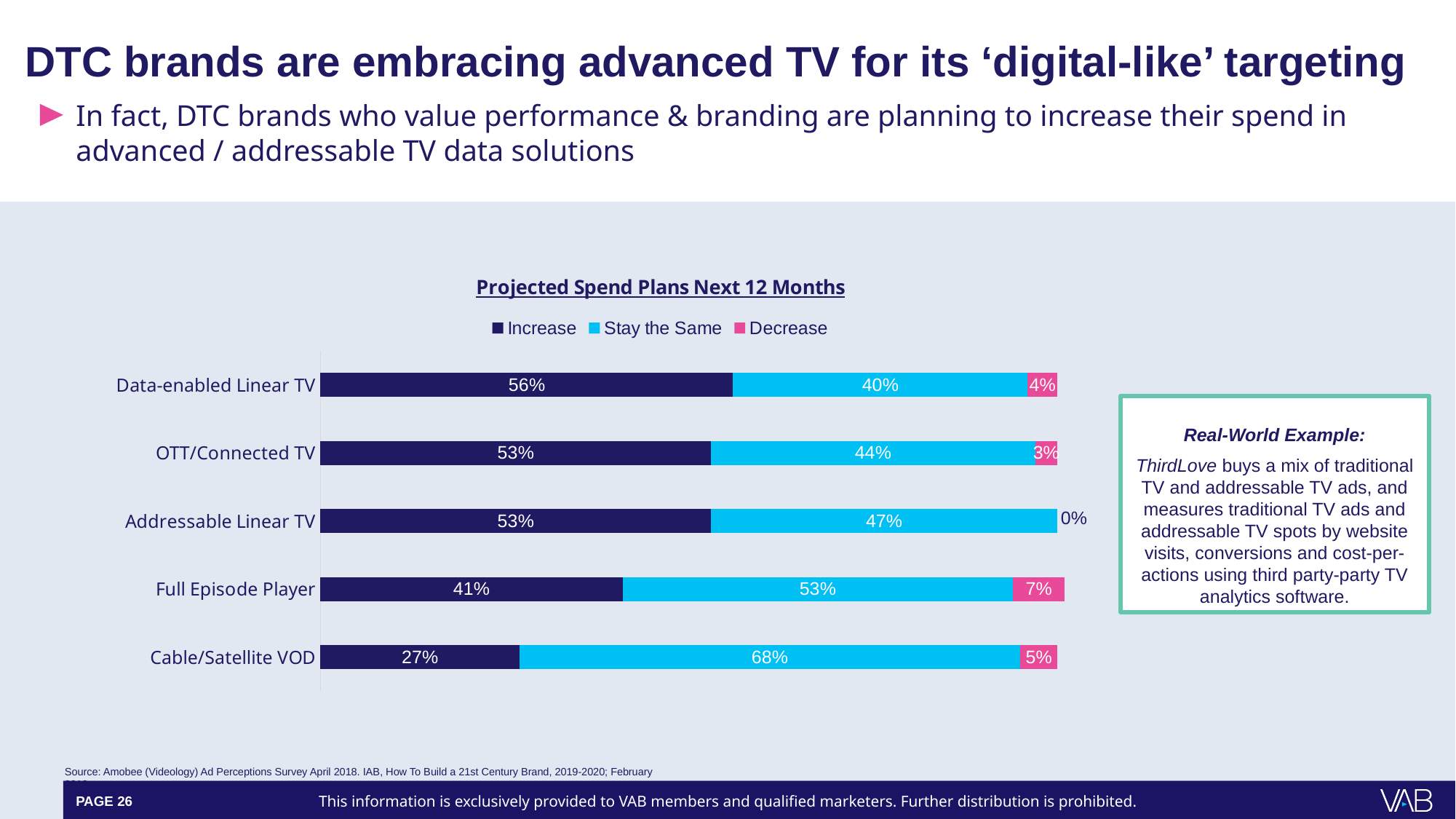
What is the Increase value for Data-enabled Linear TV? 56% What is the Decrease value for Addressable Linear TV? 0% Which category has the highest Increase value? Data-enabled Linear TV What is the Decrease value for Full Episode Player? 7% What is the difference between the Increase values for Data-enabled Linear TV and Cable/Satellite VOD? 29% What is the title of the chart? Projected Spend Plans Next 12 Months Which category has the lowest Increase value? Cable/Satellite VOD How many series does the legend list? 3 What kind of chart is shown on the slide? Stacked bar chart How many categories are shown in the chart? 5 Which is larger: the Stay the Same value for OTT/Connected TV or for Addressable Linear TV? Addressable Linear TV What is the Stay the Same value for Cable/Satellite VOD? 68%